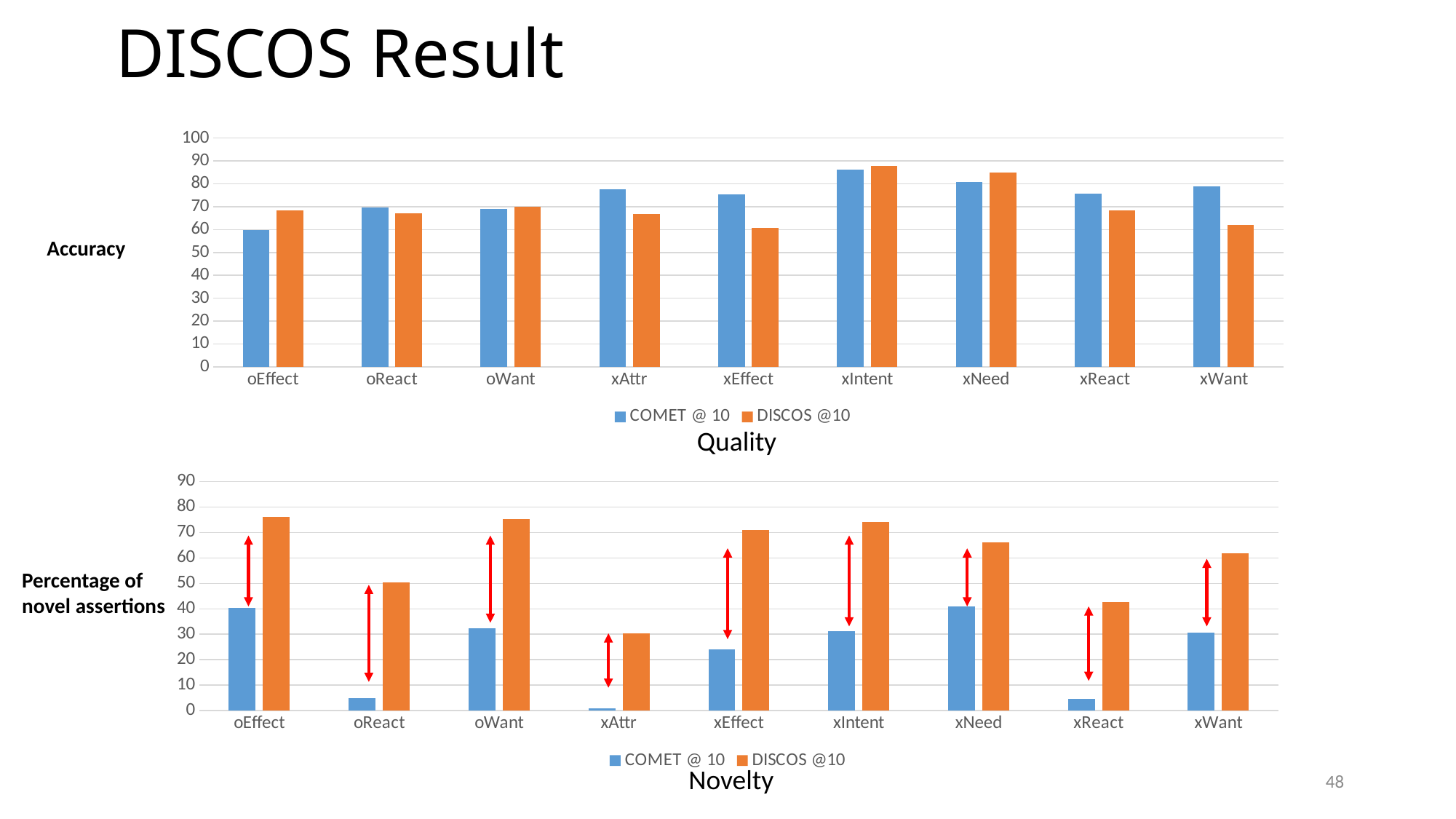
How many categories are shown on the x axis of the Novelty chart? 9 In the Quality chart, which category has the highest COMET @ 10 value? xIntent What kind of chart is the Quality chart? bar chart In the Quality chart, is the DISCOS @10 value for xEffect greater or less than 70? less What is the y-axis label of the Novelty chart? Percentage of novel assertions In the Novelty chart, which category has the lowest COMET @ 10 value? xAttr In the Novelty chart, which is larger for xAttr: COMET @ 10 or DISCOS @10? DISCOS @10 In the Novelty chart, is the DISCOS @10 value for xIntent greater or less than 70? greater In the Quality chart, which is larger for xWant: COMET @ 10 or DISCOS @10? COMET @ 10 How many series does the legend of the Quality chart list? 2 In the Novelty chart, is the COMET @ 10 value for oReact greater or less than 10? less In the Quality chart, which category has the lowest COMET @ 10 value? oEffect